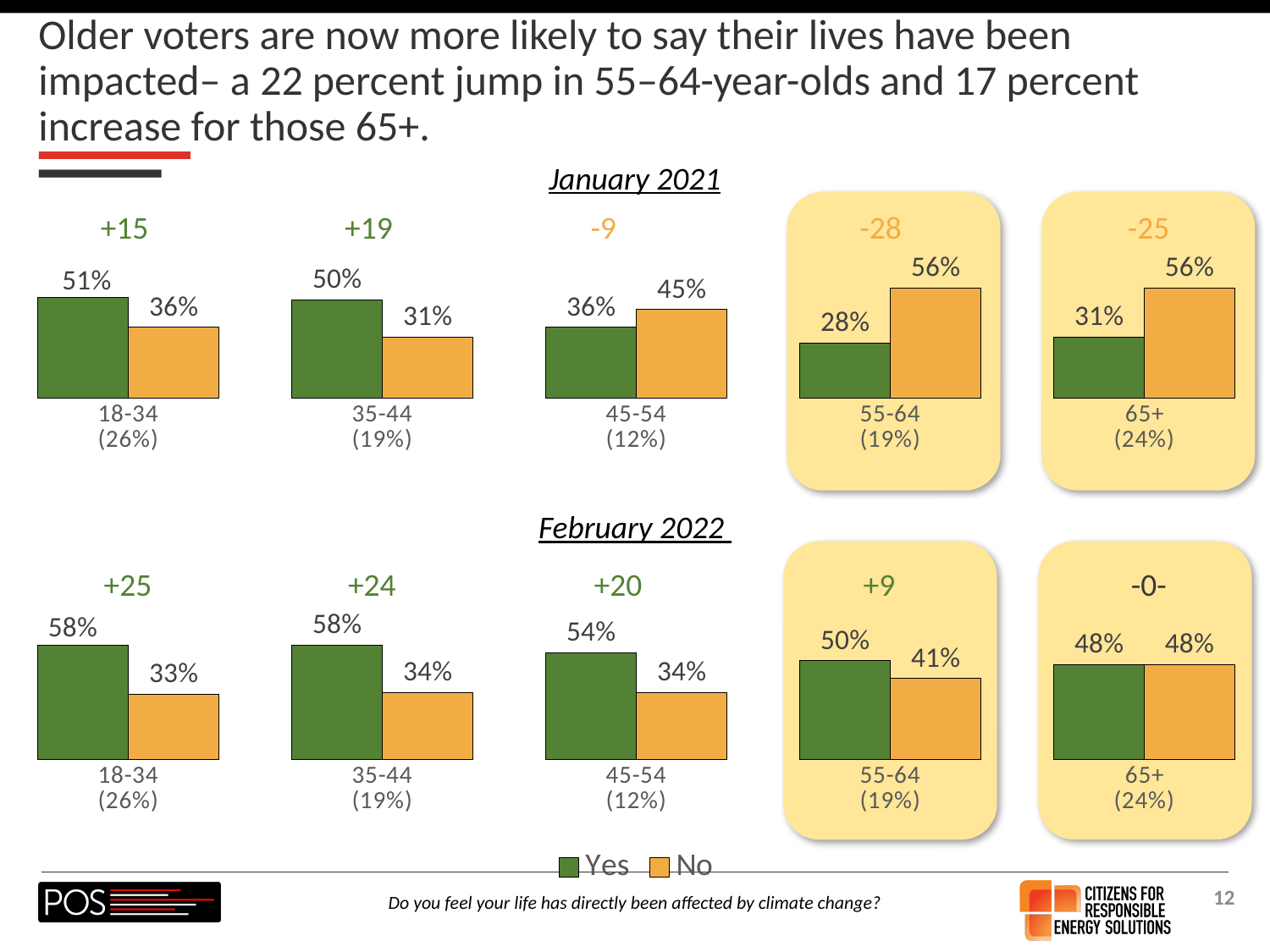
In the February 2022 chart for 18-34, what is the difference between the Yes and No percentages? 25 In the February 2022 chart for 55-64, which is larger, Yes or No? Yes How many age groups are shown in the February 2022 row of charts? 5 In the February 2022 chart for 65+, what percentage said Yes? 48% In the January 2021 chart for 35-44, what is the difference between the Yes and No percentages? 19 What type of chart is used for each age group on the slide? Bar chart Across the February 2022 charts, which age group has the highest No percentage? 65+ How many series does the legend at the bottom of the slide list? 2 Across the January 2021 charts, which age group has the lowest Yes percentage? 55-64 In the January 2021 chart for 45-54, which is larger, Yes or No? No In the February 2022 chart for 45-54, what percentage said No? 34% In the January 2021 chart for 55-64, what percentage said Yes? 28%